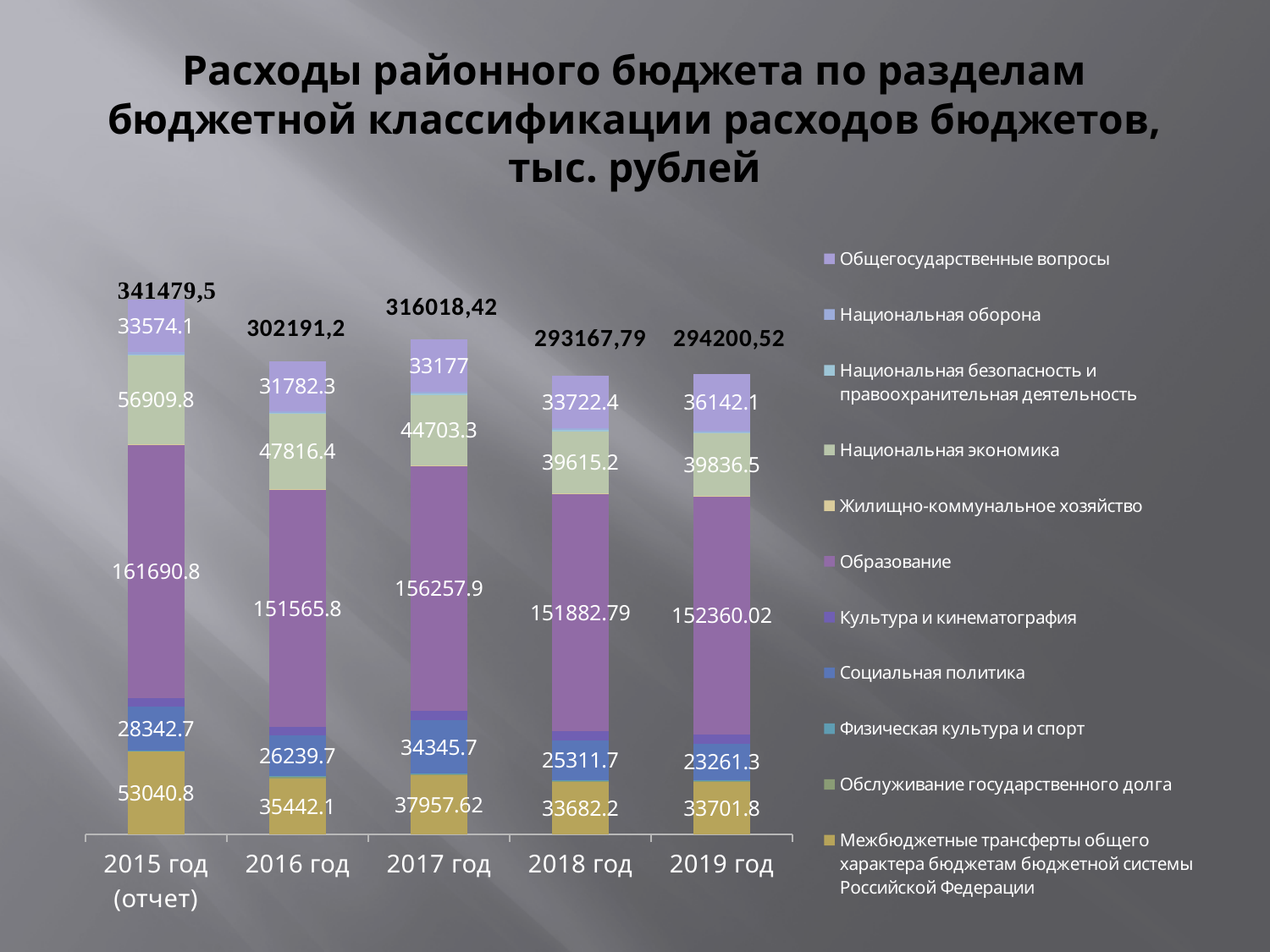
Which is larger: the Межбюджетные трансферты value in 2015 год (отчет) or in 2016 год? 2015 год (отчет) What kind of chart is shown on the slide? Stacked bar chart Which year has the lowest total expenditure? 2018 год What is the total of the stacked bar for 2017 год? 316018,42 What is the value for Социальная политика in 2018 год? 25311.7 What is the value for Образование in 2017 год? 156257.9 Which year has the highest total expenditure? 2015 год (отчет) What is the value for Общегосударственные вопросы in 2019 год? 36142.1 How many series does the legend list? 11 How many years (categories) are shown on the x axis? 5 What is the difference between the Образование values for 2015 год (отчет) and 2016 год? 10125 What is the value for Национальная экономика in 2015 год (отчет)? 56909.8